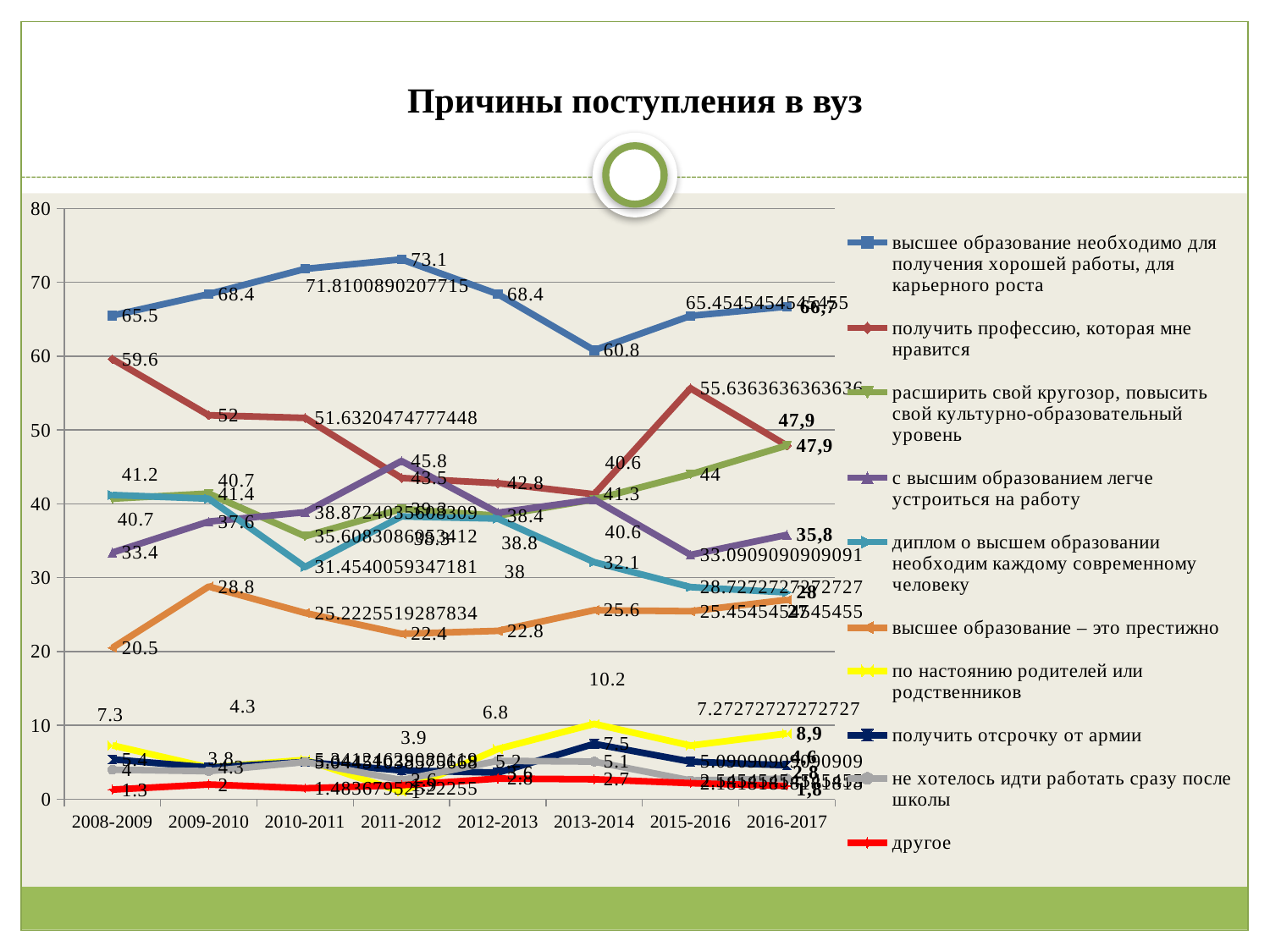
What is the difference between the 2011-2012 and 2013-2014 values of 'высшее образование необходимо для получения хорошей работы, для карьерного роста'? 12.3 How many series does the legend list? 10 What is the value for 'получить профессию, которая мне нравится' in 2008-2009? 59.6 Does the series 'получить профессию, которая мне нравится' rise or fall from 2008-2009 to 2013-2014? fall How many academic-year categories are shown on the x axis? 8 What is the value for 'высшее образование необходимо для получения хорошей работы, для карьерного роста' in 2011-2012? 73.1 What is the value for 'высшее образование – это престижно' in 2008-2009? 20.5 In which year does the series 'высшее образование необходимо для получения хорошей работы, для карьерного роста' have its lowest value? 2013-2014 What is the value for 'по настоянию родителей или родственников' in 2013-2014? 10.2 What kind of chart is shown on the slide? line chart In which year does the series 'высшее образование необходимо для получения хорошей работы, для карьерного роста' reach its highest value? 2011-2012 In 2008-2009, which is larger: 'высшее образование необходимо для получения хорошей работы, для карьерного роста' or 'получить профессию, которая мне нравится'? высшее образование необходимо для получения хорошей работы, для карьерного роста